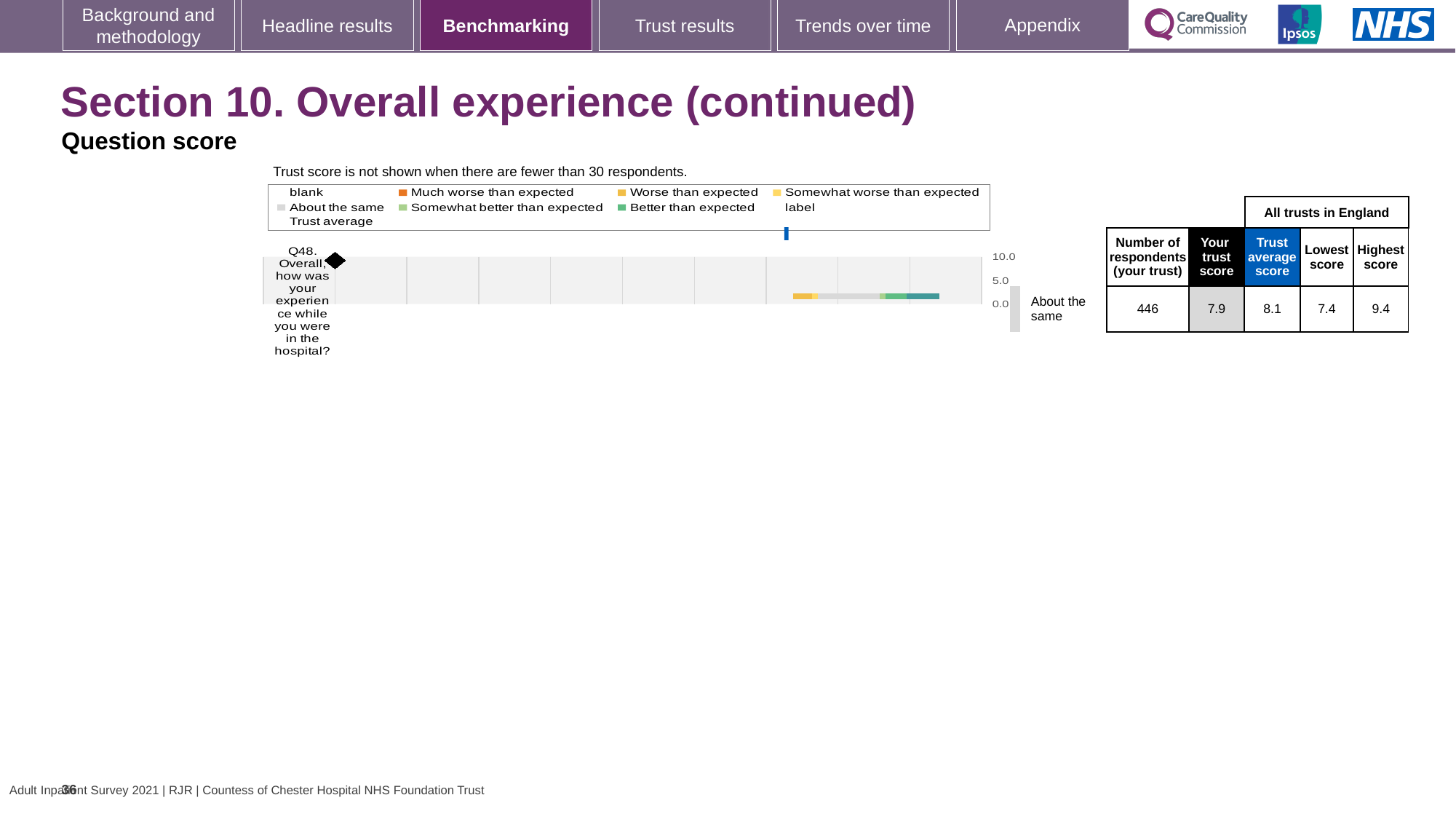
Which is larger for Q48: the trust's own score or the trust average score? Trust average score How many respondents from the trust answered Q48? 446 What is the highest score across all trusts in England for Q48? 9.4 Is the trust score for Q48 greater or less than 5.0? greater Which question is plotted in the benchmarking chart? Q48. Overall, how was your experience while you were in the hospital? What is the lowest score across all trusts in England for Q48? 7.4 What benchmark category is the trust's Q48 result placed in? About the same What is the trust average score for Q48 shown next to the chart? 8.1 What is the difference between the highest and lowest scores for Q48? 2.0 What kind of chart is used to show the Q48 benchmarking result? Bar chart How many survey questions are plotted in the benchmarking chart? 1 What is the trust score for Q48 shown next to the chart? 7.9